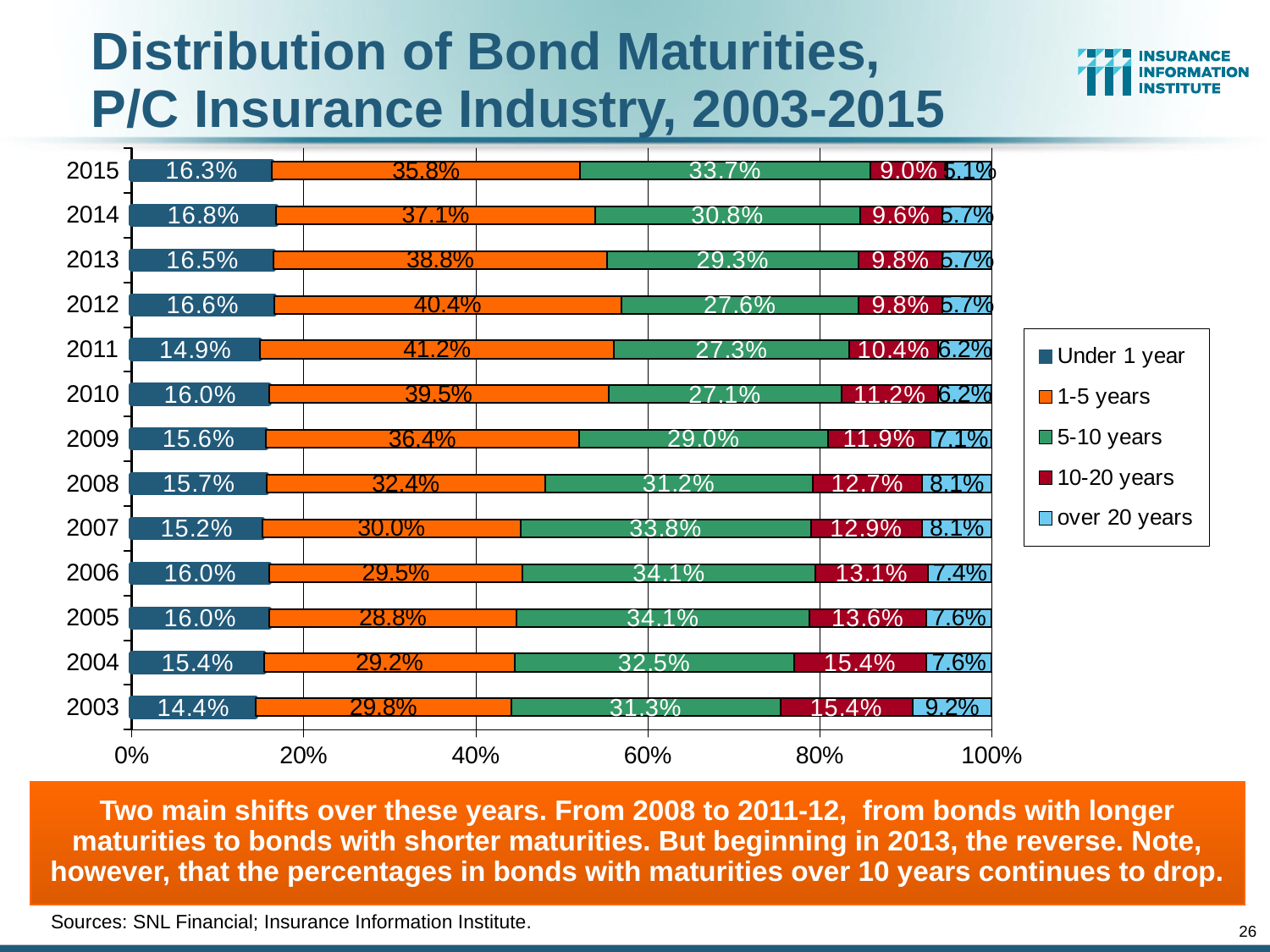
Does the 10-20 years share rise or fall from 2003 to 2015? Fall What is the value for 1-5 years in 2015? 35.8% How many years are shown on the chart? 13 Which legend entry is shown in dark red? 10-20 years What is the value for 10-20 years in 2003? 15.4% What kind of chart is shown on the slide? Stacked bar chart Which is larger in 2012: the 1-5 years share or the 5-10 years share? 1-5 years In which year is the Under 1 year share the lowest? 2003 How many series does the legend list? 5 What is the difference between the 1-5 years share in 2011 and in 2003? 11.4% In which year is the 1-5 years share the highest? 2011 What is the value for 5-10 years in 2007? 33.8%